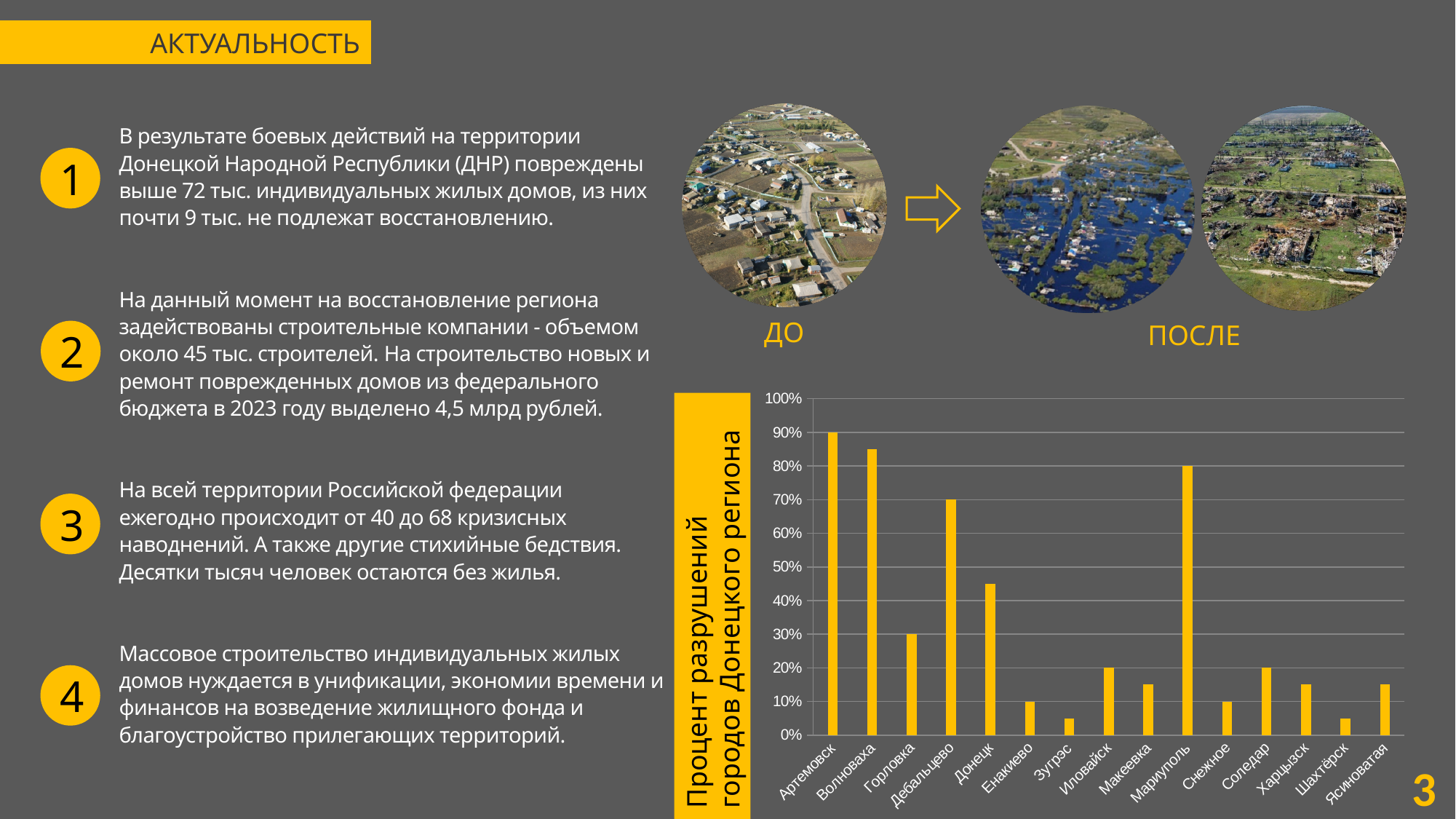
What is the value for Дебальцево? 70% Which is larger, the value for Мариуполь or the value for Дебальцево? Мариуполь Which city has the highest value in the chart? Артемовск What is the title of the chart? Процент разрушений городов Донецкого региона Is the value for Донецк greater or less than 40%? greater What is the value for Мариуполь? 80% What is the value for Артемовск? 90% Is the value for Волноваха greater or less than 80%? greater What is the value for Горловка? 30% What is the difference between the values for Артемовск and Дебальцево? 20% What kind of chart is shown on the slide? bar chart How many cities are shown on the x axis of the chart? 15